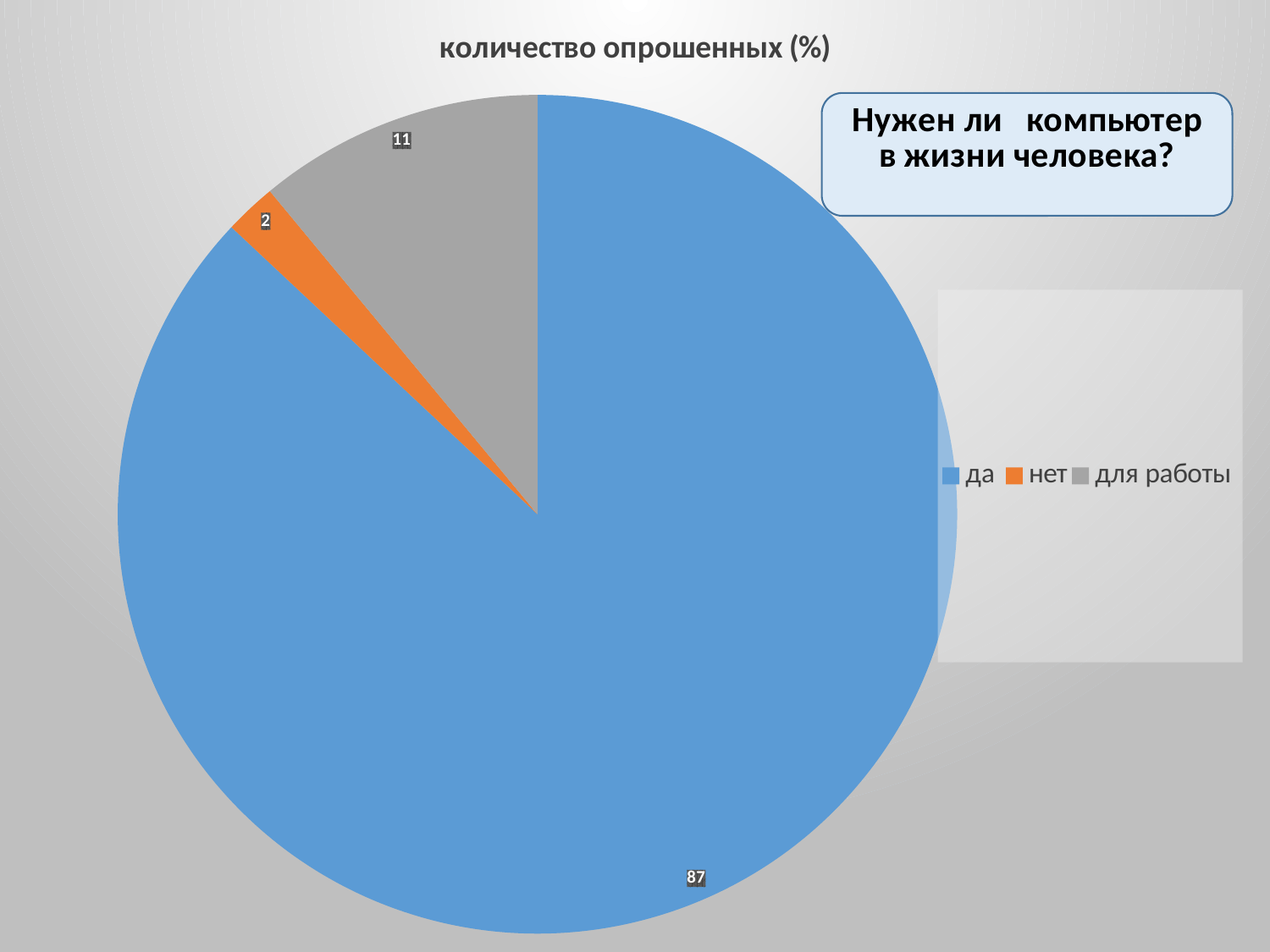
What is the difference between the values for 'да' and 'для работы'? 76 What is the value for the 'нет' slice? 2 What is the value for the 'для работы' slice? 11 Which category has the smallest slice? нет What is the title of the chart? количество опрошенных (%) What colour is the 'нет' slice? orange What type of chart is shown on the slide? pie chart What is the value for the 'да' slice? 87 How many slices does the pie chart have? 3 Which is larger, the value for 'для работы' or the value for 'нет'? для работы What is the difference between the values for 'для работы' and 'нет'? 9 Which category has the largest slice? да